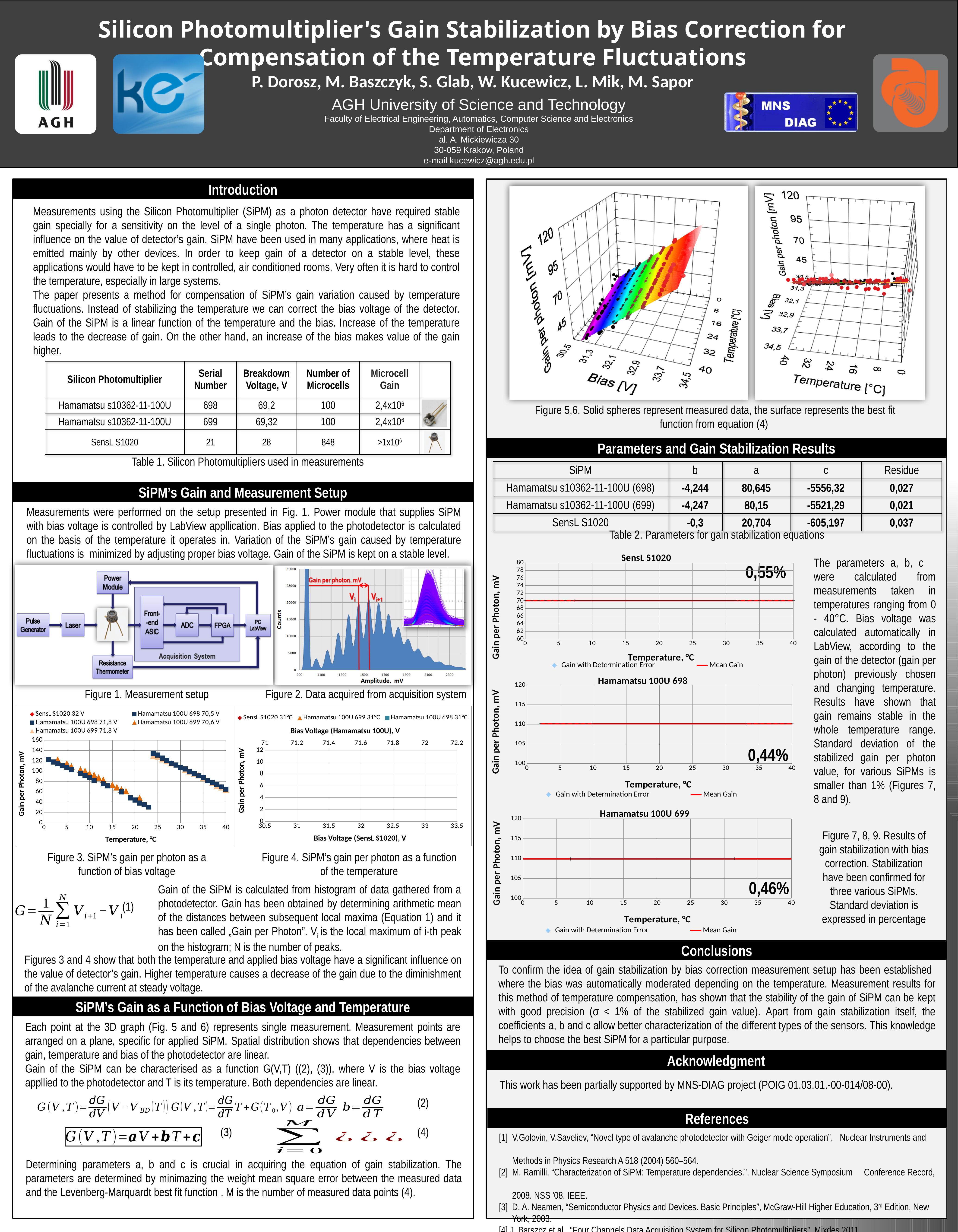
What is the y-axis label of the "Hamamatsu 100U 699" gain stabilization chart? Gain per Photon, mV On the chart titled "SensL S1020" (gain stabilization results), what percentage value is printed on the plot area? 0,55% On the chart titled "Hamamatsu 100U 698" (gain stabilization results), what percentage value is printed on the plot area? 0,44% On the "SensL S1020" gain stabilization chart, is the Mean Gain line greater or less than 60 mV? greater How many series does the legend list on the chart in the lower left with Temperature, °C on the x axis (Figure 3)? 5 Among the three gain stabilization charts (SensL S1020, Hamamatsu 100U 698, Hamamatsu 100U 699), which one shows the largest printed percentage? SensL S1020 What is the difference between the percentage printed on the "Hamamatsu 100U 699" chart and the percentage printed on the "Hamamatsu 100U 698" chart? 0,02% Among the three gain stabilization charts (SensL S1020, Hamamatsu 100U 698, Hamamatsu 100U 699), which one shows the smallest printed percentage? Hamamatsu 100U 698 How many series does the legend of the "SensL S1020" gain stabilization chart list? 2 On the chart in the lower left with Temperature, °C on the x axis and Gain per Photon, mV on the y axis (Figure 3), do the plotted values rise or fall as temperature increases? fall On the "Hamamatsu 100U 698" gain stabilization chart, is the Mean Gain line greater or less than 105 mV? greater On the chart titled "Hamamatsu 100U 699" (gain stabilization results), what percentage value is printed on the plot area? 0,46%